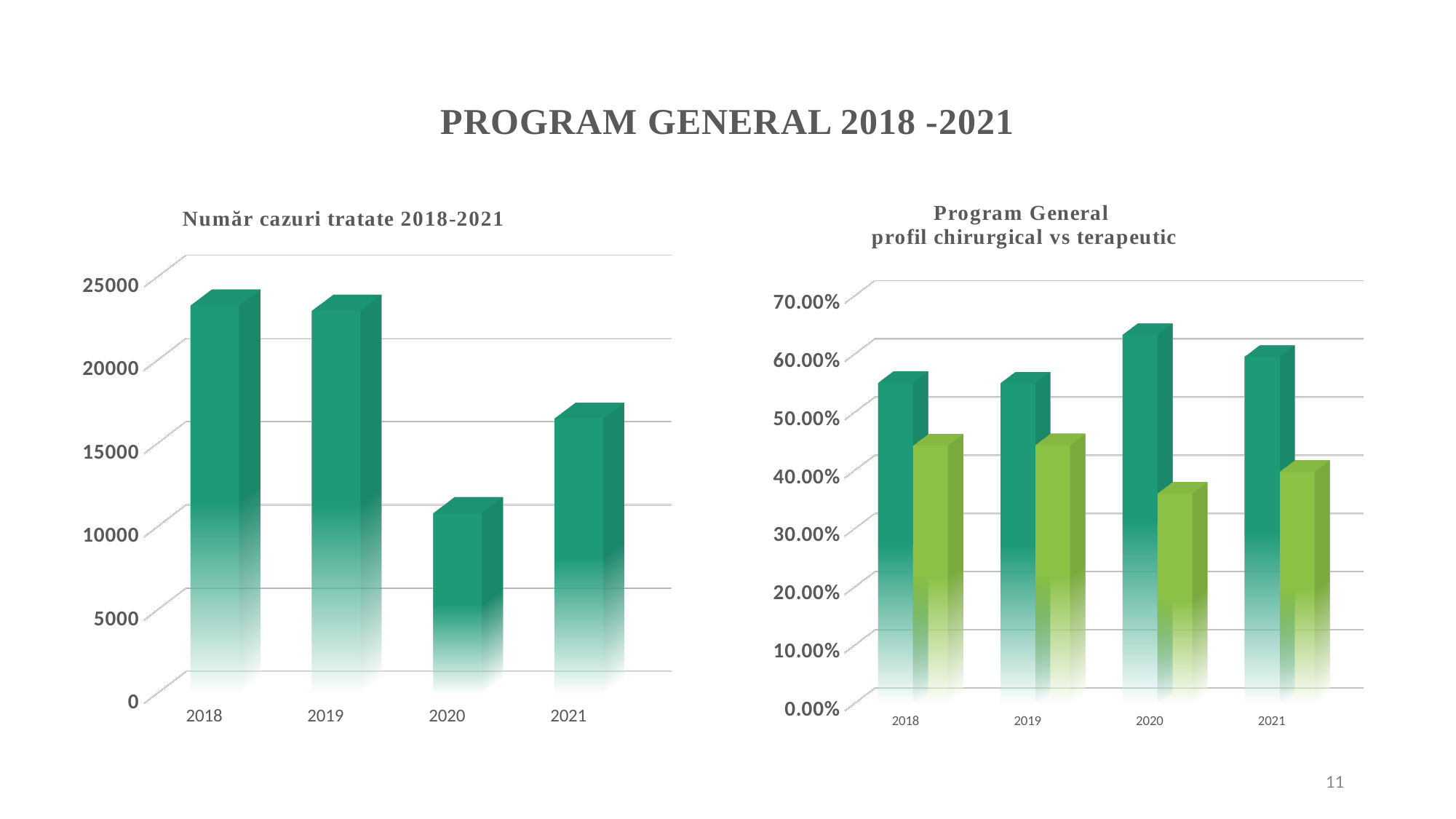
In the left chart 'Număr cazuri tratate 2018-2021', which year has the lowest value? 2020 In the left chart 'Număr cazuri tratate 2018-2021', which is larger, the value for 2019 or the value for 2021? 2019 In the left chart 'Număr cazuri tratate 2018-2021', is the value for 2021 greater or less than 15000? greater How many years are shown on the x axis of the left chart 'Număr cazuri tratate 2018-2021'? 4 In the left chart 'Număr cazuri tratate 2018-2021', is the value for 2018 greater or less than 20000? greater In the right chart 'Program General profil chirurgical vs terapeutic', is the dark green bar for 2020 greater or less than 60.00%? greater In the left chart 'Număr cazuri tratate 2018-2021', do the values rise or fall from 2018 to 2020? fall What is the title of the right chart? Program General profil chirurgical vs terapeutic What kind of chart is the left chart titled 'Număr cazuri tratate 2018-2021'? bar chart In the right chart 'Program General profil chirurgical vs terapeutic', which is larger for 2021, the dark green bar or the light green bar? dark green bar